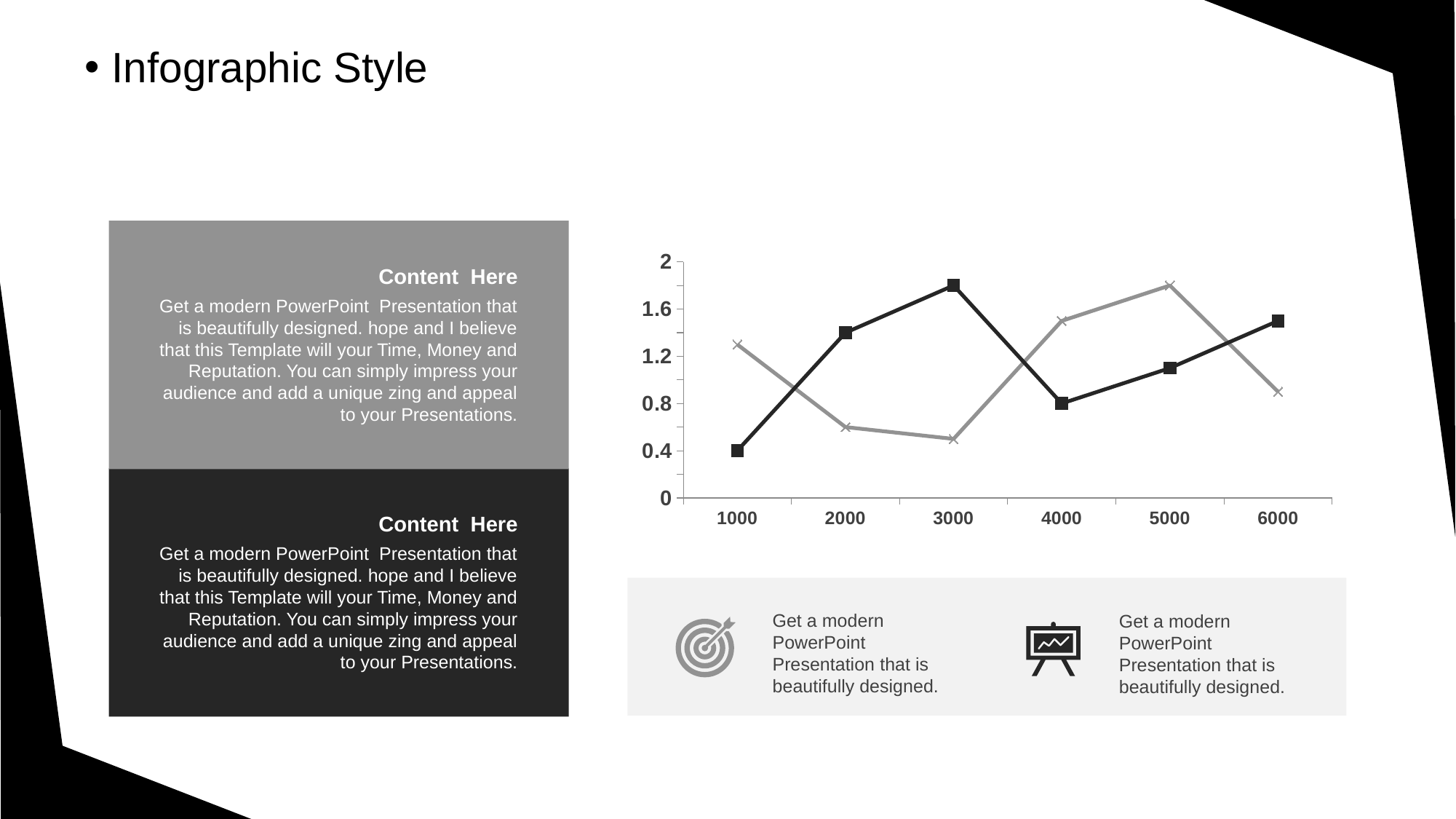
What is the value of the black line with square markers at 4000? 0.8 What is the value of the black line with square markers at 1000? 0.4 What kind of chart is shown on the slide? line chart At which x-axis value does the black square-marker line reach its highest point? 3000 Is the value of the black square-marker line at 3000 greater or less than 1.6? greater At which x-axis value does the gray x-marker line reach its lowest point? 3000 How many lines are plotted on the chart? 2 Is the value of the gray x-marker line at 5000 greater or less than 1.6? greater At 2000, which line has the higher value, the black square-marker line or the gray x-marker line? the black square-marker line Does the gray x-marker line rise or fall between 1000 and 2000? fall Is the value of the gray x-marker line at 3000 greater or less than 0.8? less How many points are plotted along the x axis for each line? 6